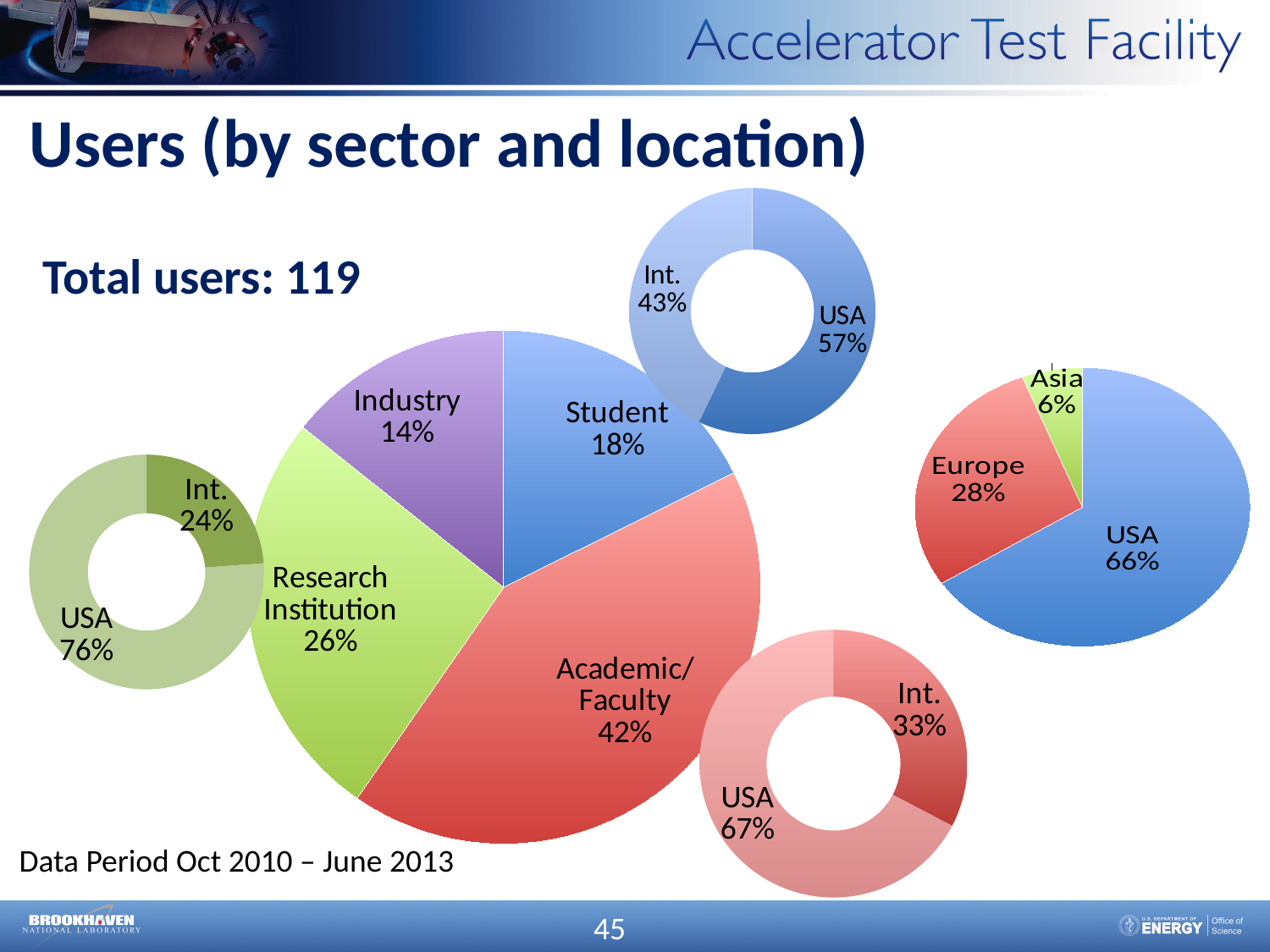
On the green donut chart on the left, what share of users is international (Int.)? 24% What type of chart is the large central chart? Pie chart On the large central pie chart, how many sectors are shown? 4 On the pie chart on the right, what share of users is from Europe? 28% On the large central pie chart, which sector has the smallest share? Industry On the large central pie chart, what share of users is Academic/Faculty? 42% On the red donut chart at the bottom, which is larger, USA or Int.? USA On the large central pie chart, which sector has the largest share? Academic/Faculty On the pie chart on the right, which region has the smallest share? Asia On the large central pie chart, what is the difference between the Research Institution share and the Student share? 8% On the large central pie chart, what share of users is Industry? 14% On the blue donut chart at the top, what share of users is from the USA? 57%